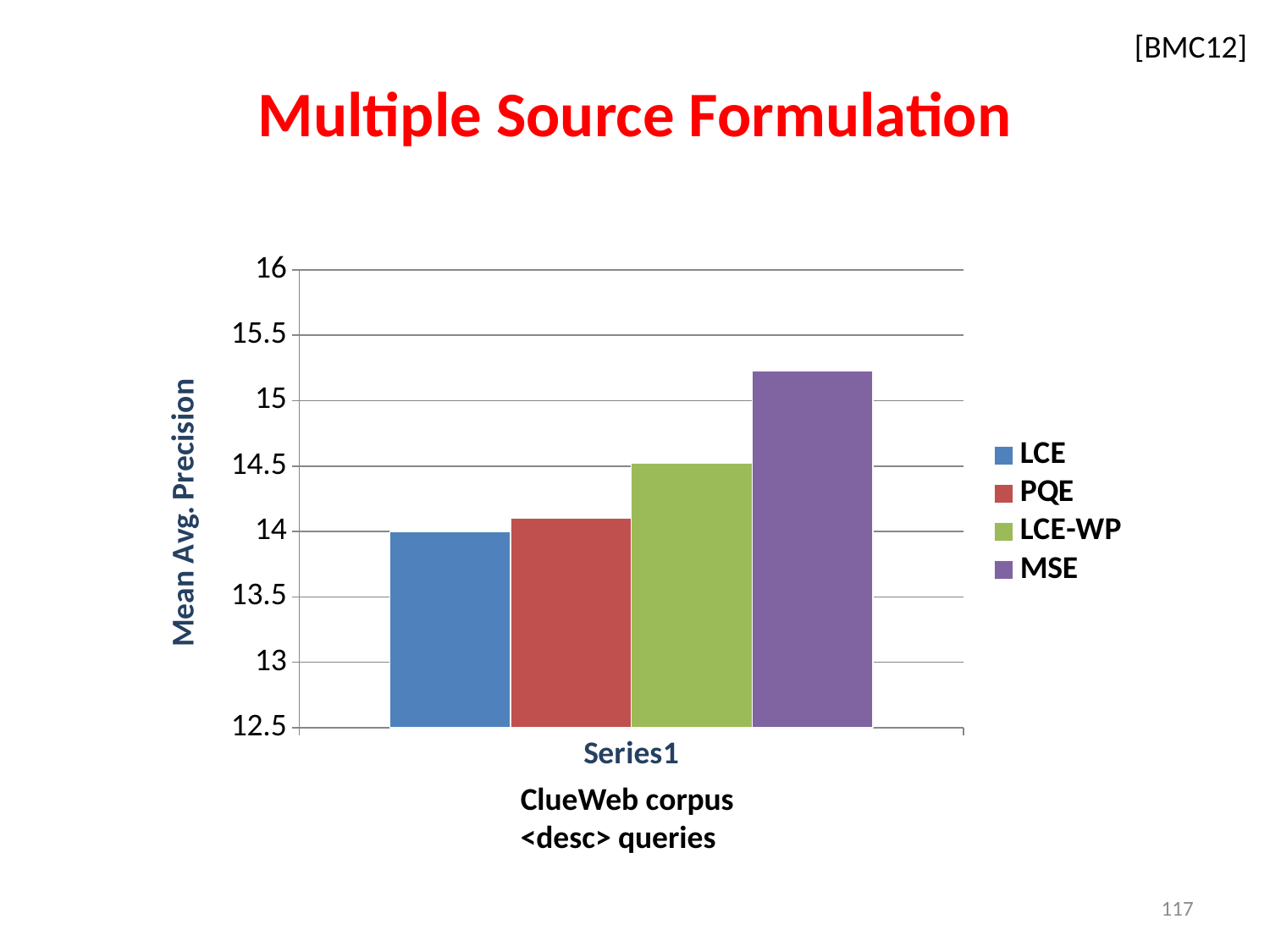
How many series does the legend list? 4 Is the value for MSE greater or less than 15.5? less Which is larger, the value for MSE or the value for LCE-WP? MSE Which is larger, the value for LCE-WP or the value for PQE? LCE-WP Which series is shown in purple in the legend? MSE What kind of chart is shown on the slide? bar chart Which series has the highest Mean Avg. Precision? MSE Is the value for LCE greater or less than 14.5? less Is the value for MSE greater or less than 15? greater What is the title of the vertical axis? Mean Avg. Precision